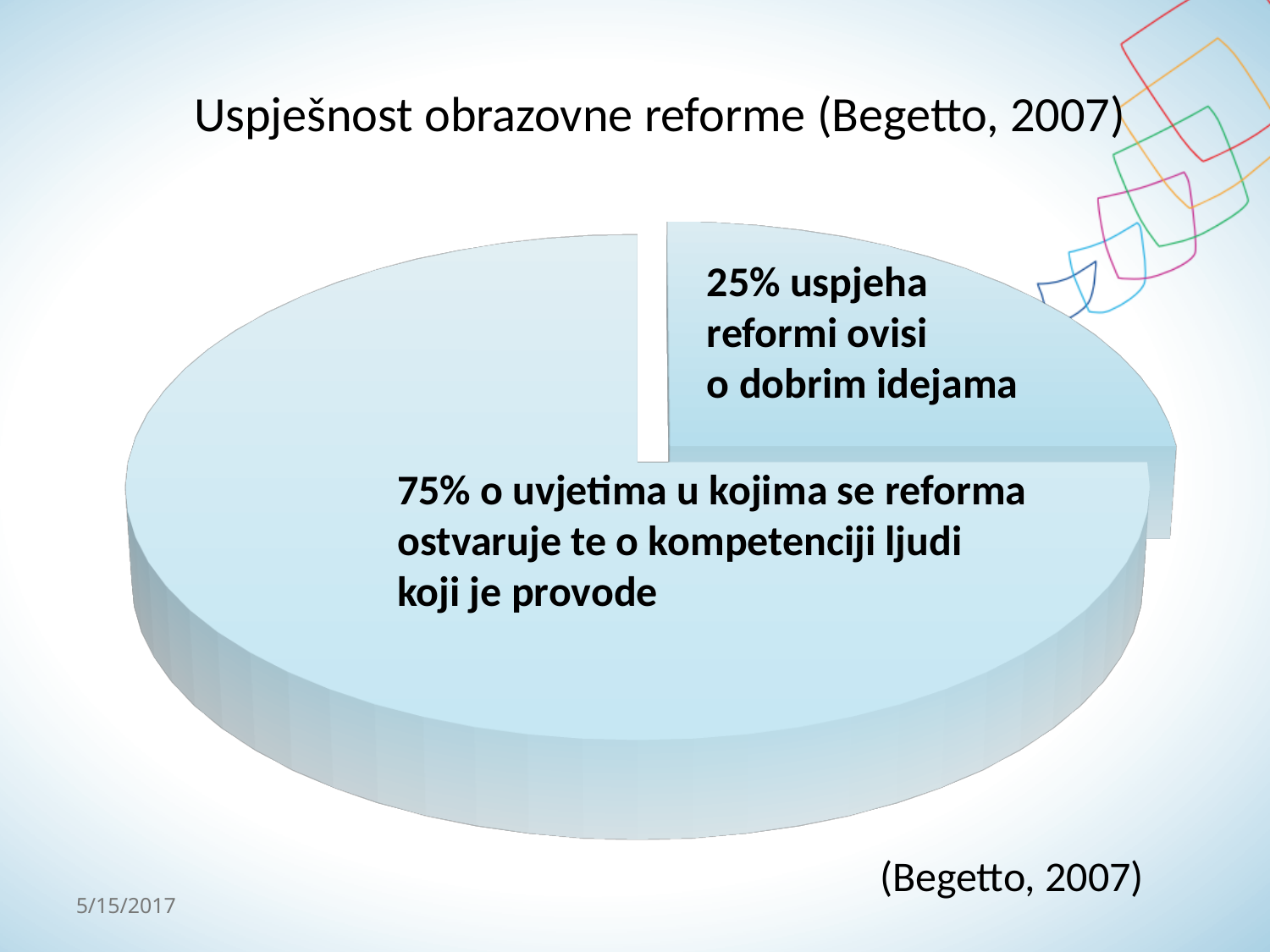
What kind of chart is shown on the slide? pie chart What is the title of the slide containing the pie chart? Uspješnost obrazovne reforme (Begetto, 2007) Which source is cited for the data in the pie chart? Begetto, 2007 What is the difference in percentage points between the larger and the smaller slice of the pie chart? 50 What is the total of the two slices shown in the pie chart? 100% How many slices does the pie chart have? 2 Which slice of the pie chart is the largest? 75% o uvjetima u kojima se reforma ostvaruje te o kompetenciji ljudi koji je provode Which is larger: the share for good ideas or the share for conditions and competence of people? conditions and competence of people (75%) What share of reform success depends on good ideas (dobrim idejama) according to the pie chart? 25% What share of reform success depends on the conditions in which the reform is carried out and the competence of the people implementing it? 75% Which slice of the pie chart is the smallest? 25% uspjeha reformi ovisi o dobrim idejama